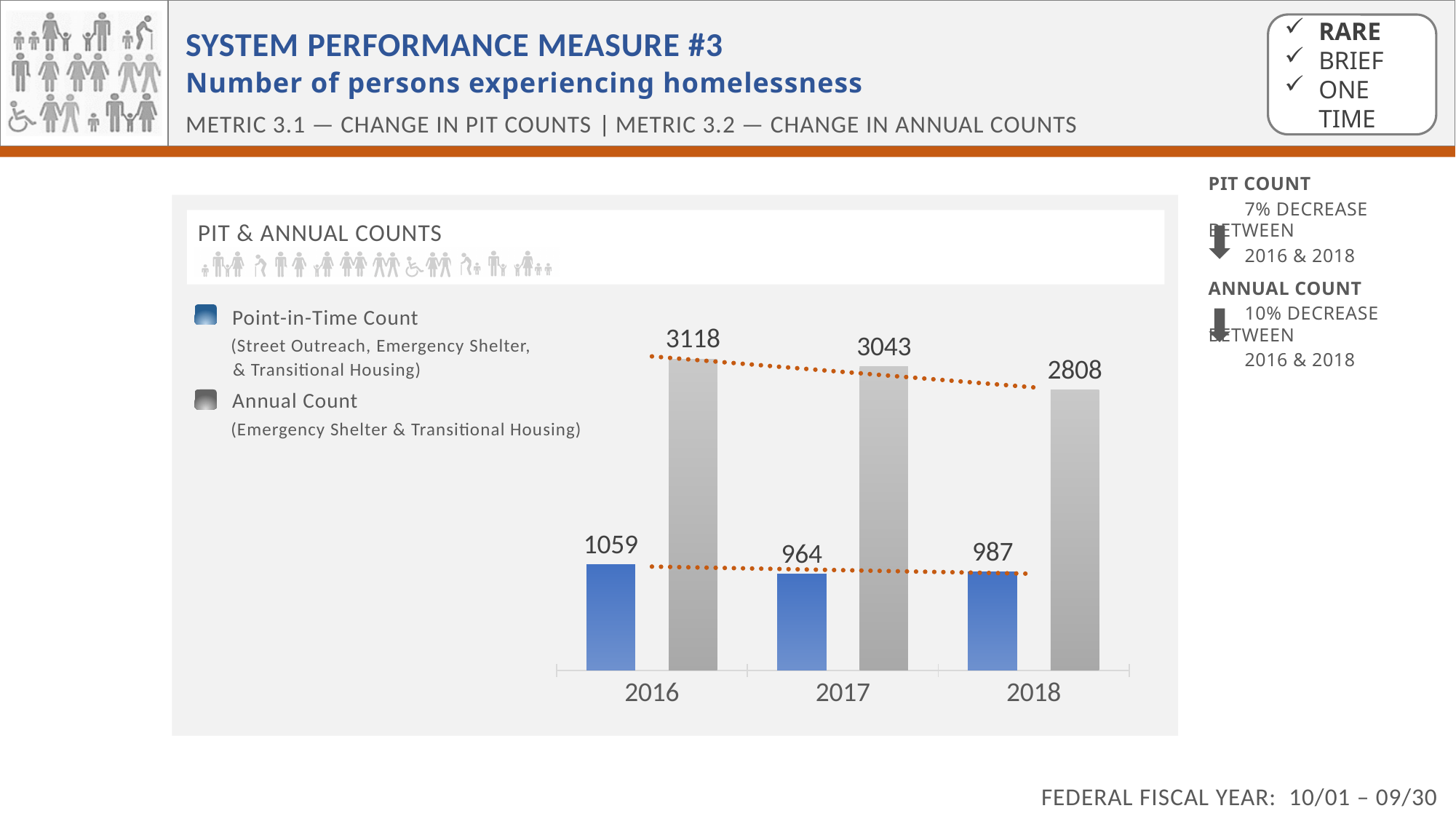
How many years are shown on the x axis of the chart? 3 What is the Annual Count for 2018? 2808 What is the Annual Count for 2017? 3043 How many series does the chart's legend list? 2 Which is larger, the Point-in-Time Count for 2018 or the Point-in-Time Count for 2017? 2018 What is the difference between the Point-in-Time Count in 2016 and in 2017? 95 What kind of chart is shown on the slide? Bar chart Which year has the highest Annual Count? 2016 Which year has the lowest Point-in-Time Count? 2017 What is the difference between the Annual Count in 2016 and in 2018? 310 What is the Point-in-Time Count for 2016? 1059 What is the Point-in-Time Count for 2017? 964